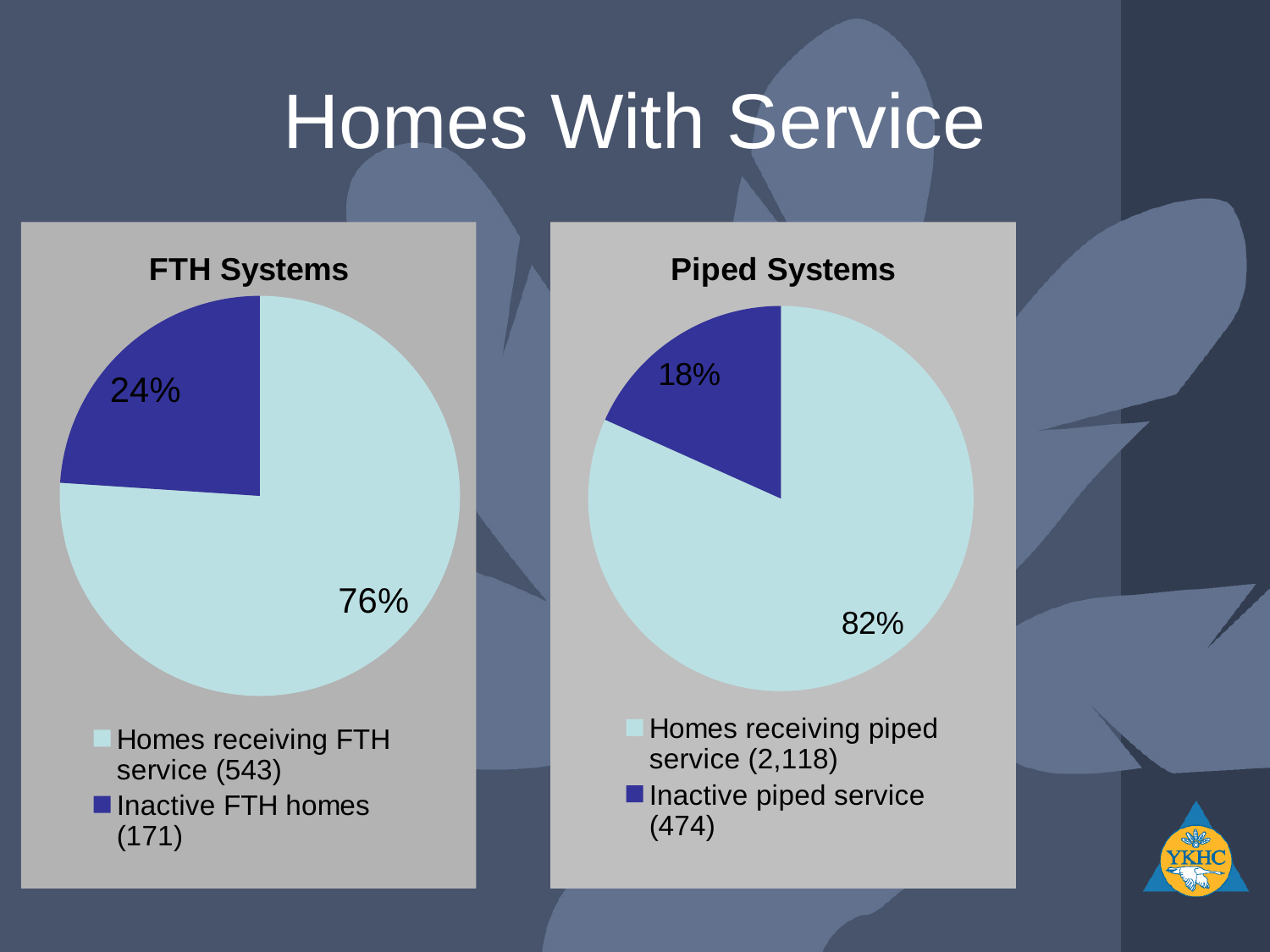
In the FTH Systems chart, which slice is the largest? Homes receiving FTH service (543) In the Piped Systems chart, what percentage is shown for Inactive piped service (474)? 18% What is the title of the chart on the right side of the slide? Piped Systems How many entries does the legend of the FTH Systems chart list? 2 How many slices does the Piped Systems pie chart have? 2 In the FTH Systems chart, what percentage is shown for Inactive FTH homes (171)? 24% In the FTH Systems chart, what is the difference in percentage points between the Homes receiving FTH service slice and the Inactive FTH homes slice? 52 In the Piped Systems chart, what percentage is shown for Homes receiving piped service (2,118)? 82% In the Piped Systems chart, which slice is the smallest? Inactive piped service (474) What type of chart is the FTH Systems chart? Pie chart In the FTH Systems chart, what percentage is shown for Homes receiving FTH service (543)? 76% Which is larger: the Inactive FTH homes share in the FTH Systems chart or the Inactive piped service share in the Piped Systems chart? Inactive FTH homes